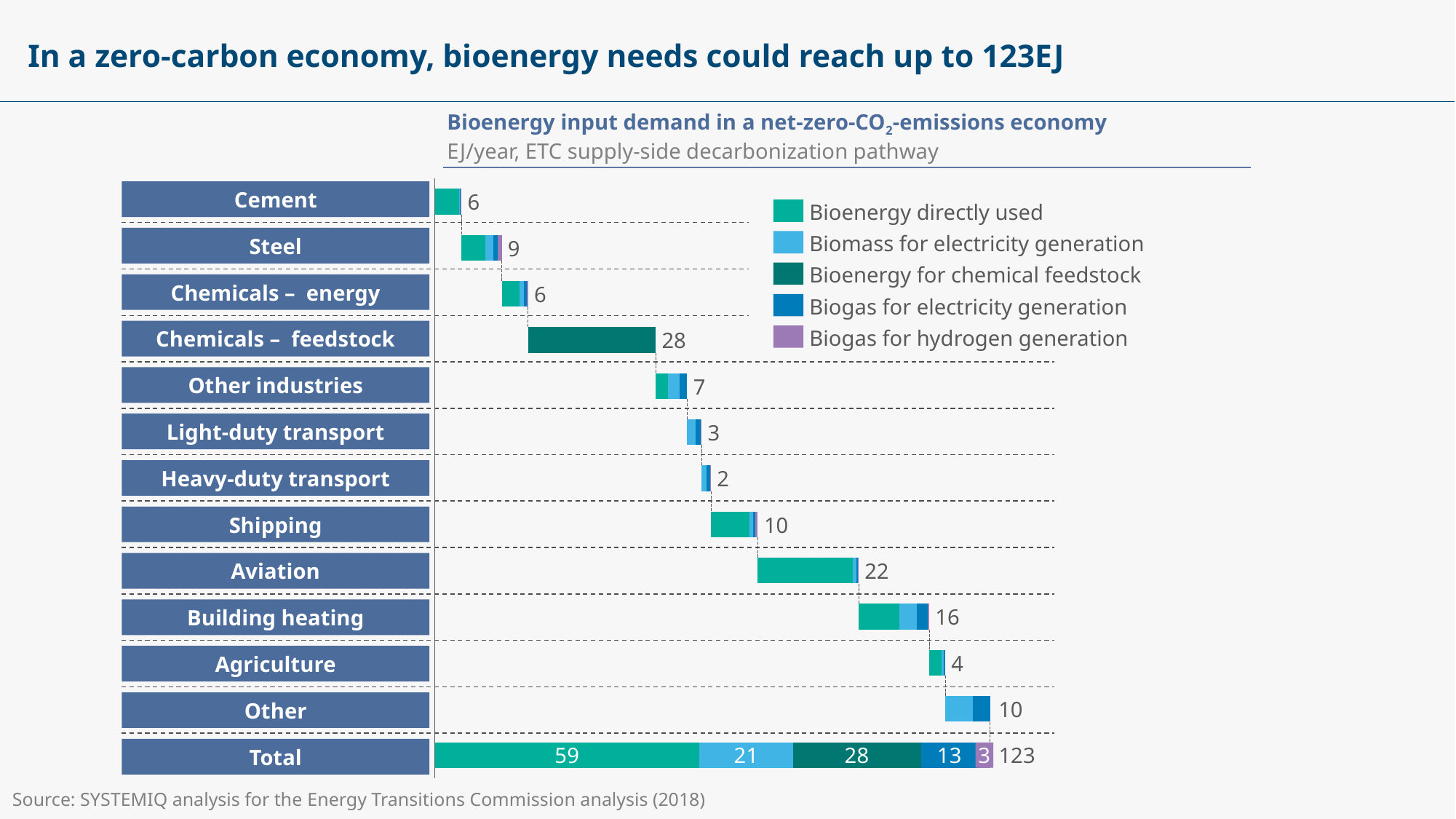
What is the value shown for Aviation? 22 What is the difference between the values for Aviation and Building heating? 6 In the Total bar, what is the value of the 'Bioenergy directly used' segment? 59 What is the value shown for Heavy-duty transport? 2 Which sector (excluding Total) has the highest bioenergy input demand? Chemicals – feedstock What is the value shown for Building heating? 16 How many series does the legend list? 5 How many sector categories are shown, not counting the Total row? 12 What is the total bioenergy input demand shown at the end of the Total bar? 123 Which has a larger value, Steel or Shipping? Shipping What is the bioenergy input demand value shown for Chemicals – feedstock? 28 Which sector has the lowest bioenergy input demand? Heavy-duty transport